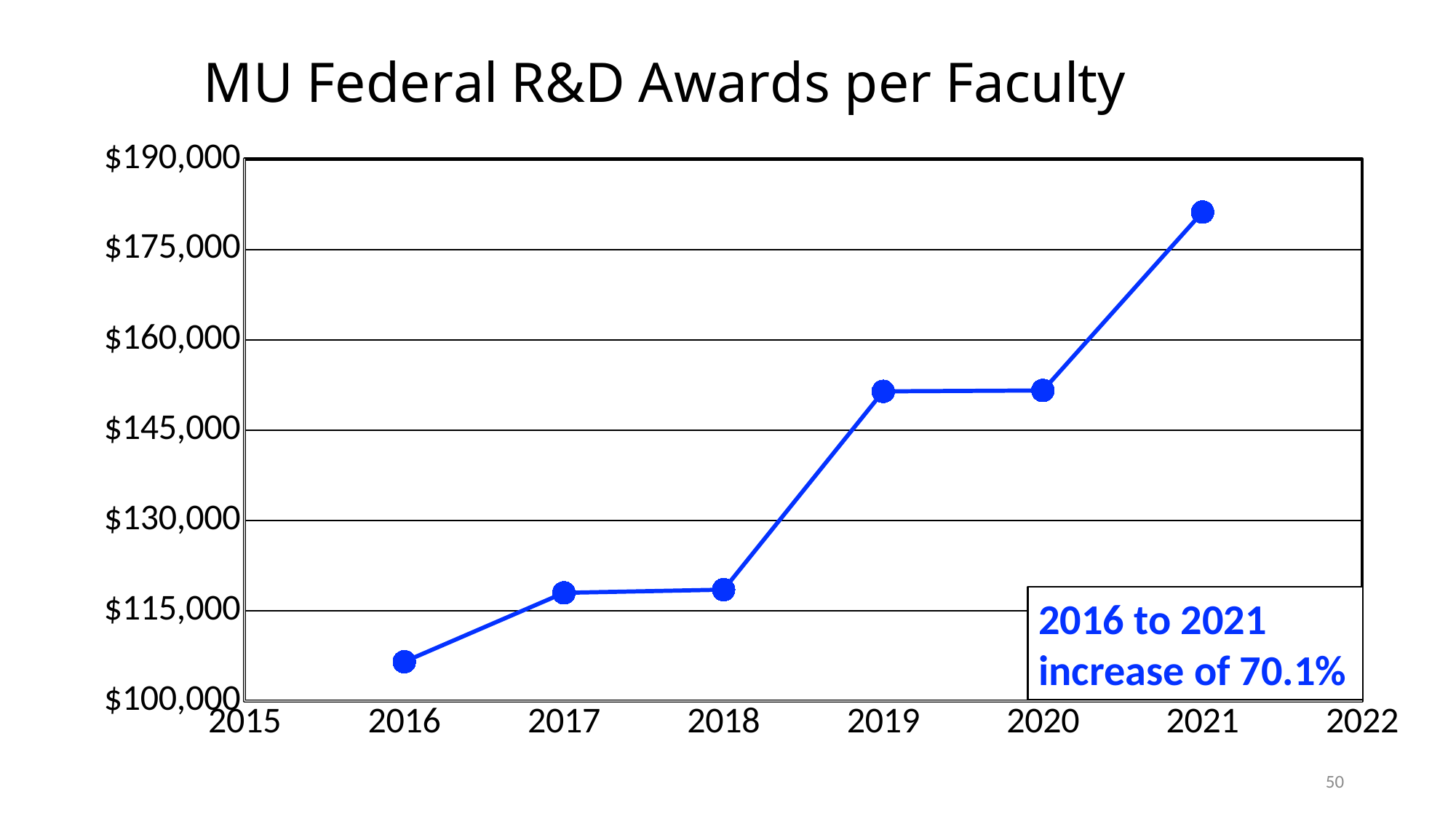
Which year has the larger value, 2017 or 2020? 2020 Is the value for 2019 greater or less than $145,000? greater According to the text box on the chart, what was the percentage increase from 2016 to 2021? 70.1% Is the value for 2021 greater or less than $175,000? greater Which year has the highest value? 2021 Is the value for 2016 greater or less than $115,000? less Which year has the lowest value? 2016 What is the title of the chart? MU Federal R&D Awards per Faculty Do the values generally rise or fall from 2016 to 2021? rise What kind of chart is shown on the slide? line chart How many data points are plotted on the line? 6